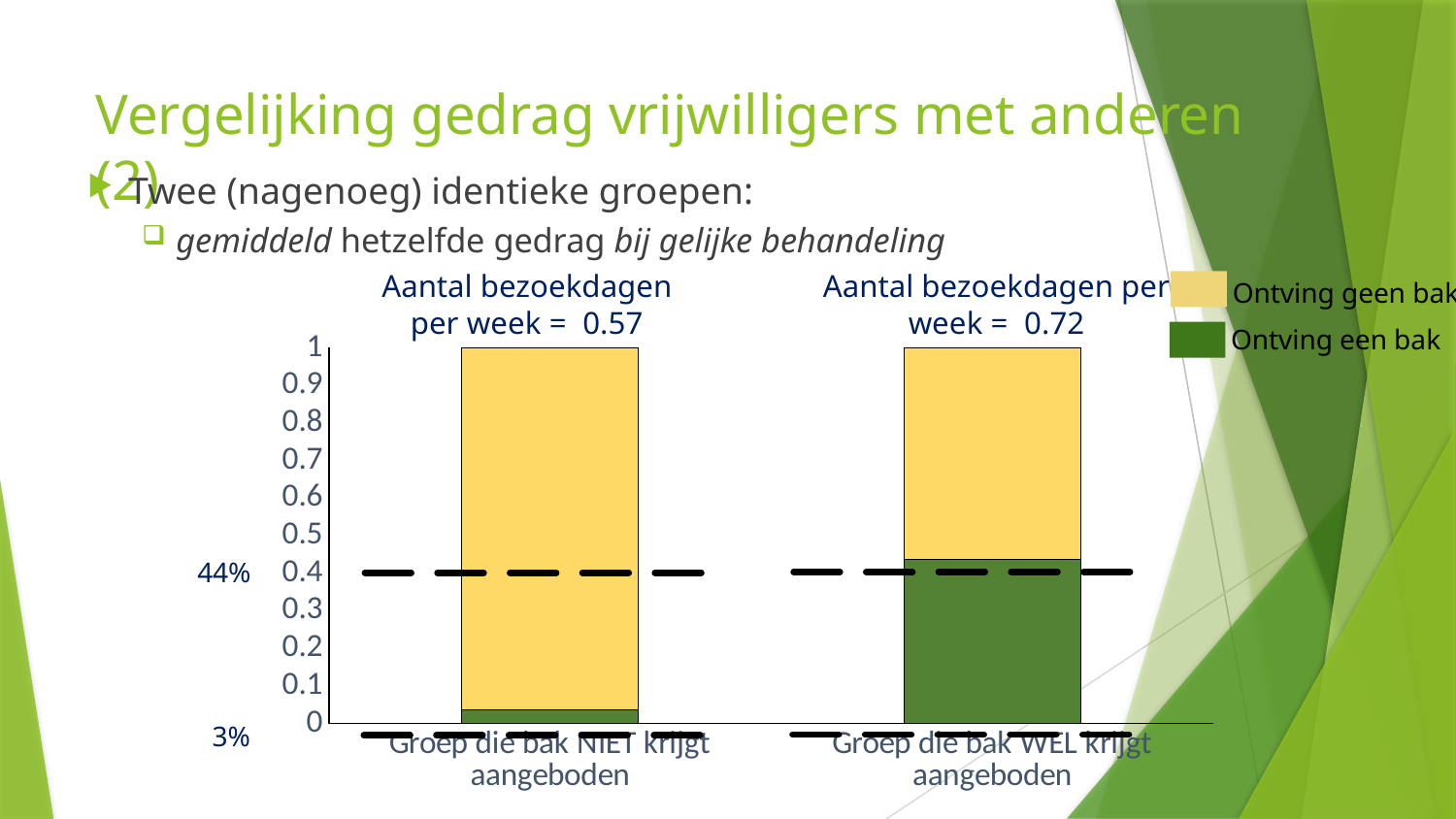
Which colour represents 'Ontving geen bak' in the legend? yellow Which group has the larger 'Ontving een bak' portion? Groep die bak WEL krijgt aangeboden How many groups (categories) are plotted on the x axis? 2 What is the difference in 'Aantal bezoekdagen per week' between the WEL group and the NIET group? 0.15 What is the 'Aantal bezoekdagen per week' for the group 'Groep die bak NIET krijgt aangeboden'? 0.57 Is the 'Ontving een bak' portion of the 'Groep die bak WEL krijgt aangeboden' bar greater or less than 0.4? greater Which group has the higher 'Aantal bezoekdagen per week'? Groep die bak WEL krijgt aangeboden How many series does the legend list? 2 What is the 'Aantal bezoekdagen per week' for the group 'Groep die bak WEL krijgt aangeboden'? 0.72 What percentage label is shown for the 'Ontving een bak' portion of the 'Groep die bak NIET krijgt aangeboden' bar? 3% What percentage label is shown for the 'Ontving een bak' portion of the 'Groep die bak WEL krijgt aangeboden' bar? 44% What kind of chart is shown on the slide? bar chart